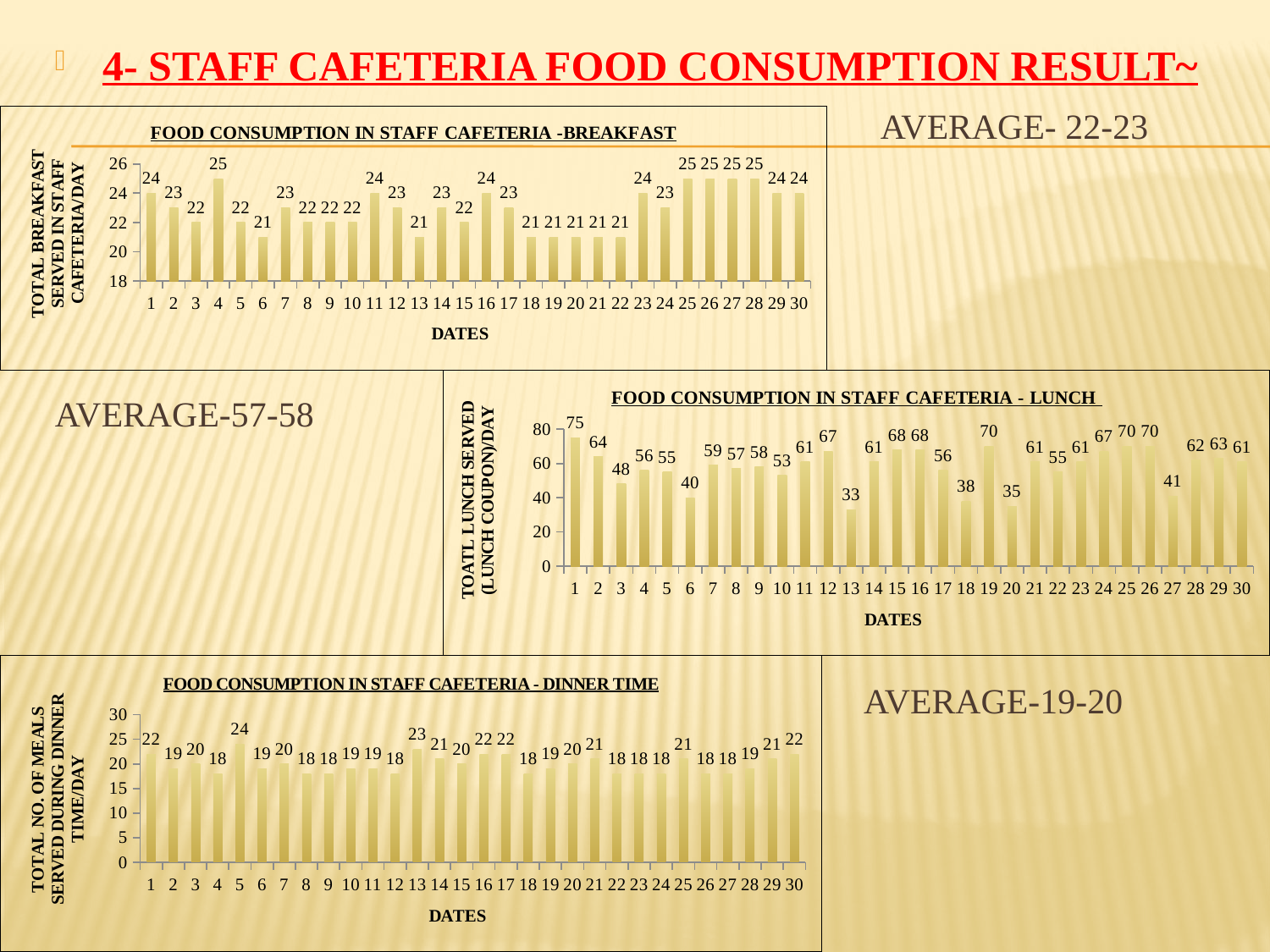
In the dinner time chart, which date has the highest value? 5 In the lunch chart, what is the difference between the values for date 1 and date 13? 42 In the dinner time chart, what is the difference between the values for date 5 and date 4? 6 In the dinner time chart, what is the value for date 13? 23 In the lunch chart, which date has the lowest value? 13 How many dates are plotted in the lunch chart? 30 In the lunch chart, what is the value for date 19? 70 In the breakfast chart, what is the value for date 4? 25 What is the title of the middle chart on the slide? FOOD CONSUMPTION IN STAFF CAFETERIA - LUNCH In the breakfast chart, which is larger, the value for date 6 or the value for date 11? date 11 What kind of chart is the breakfast chart? bar chart In the lunch chart, which date has the highest value? 1